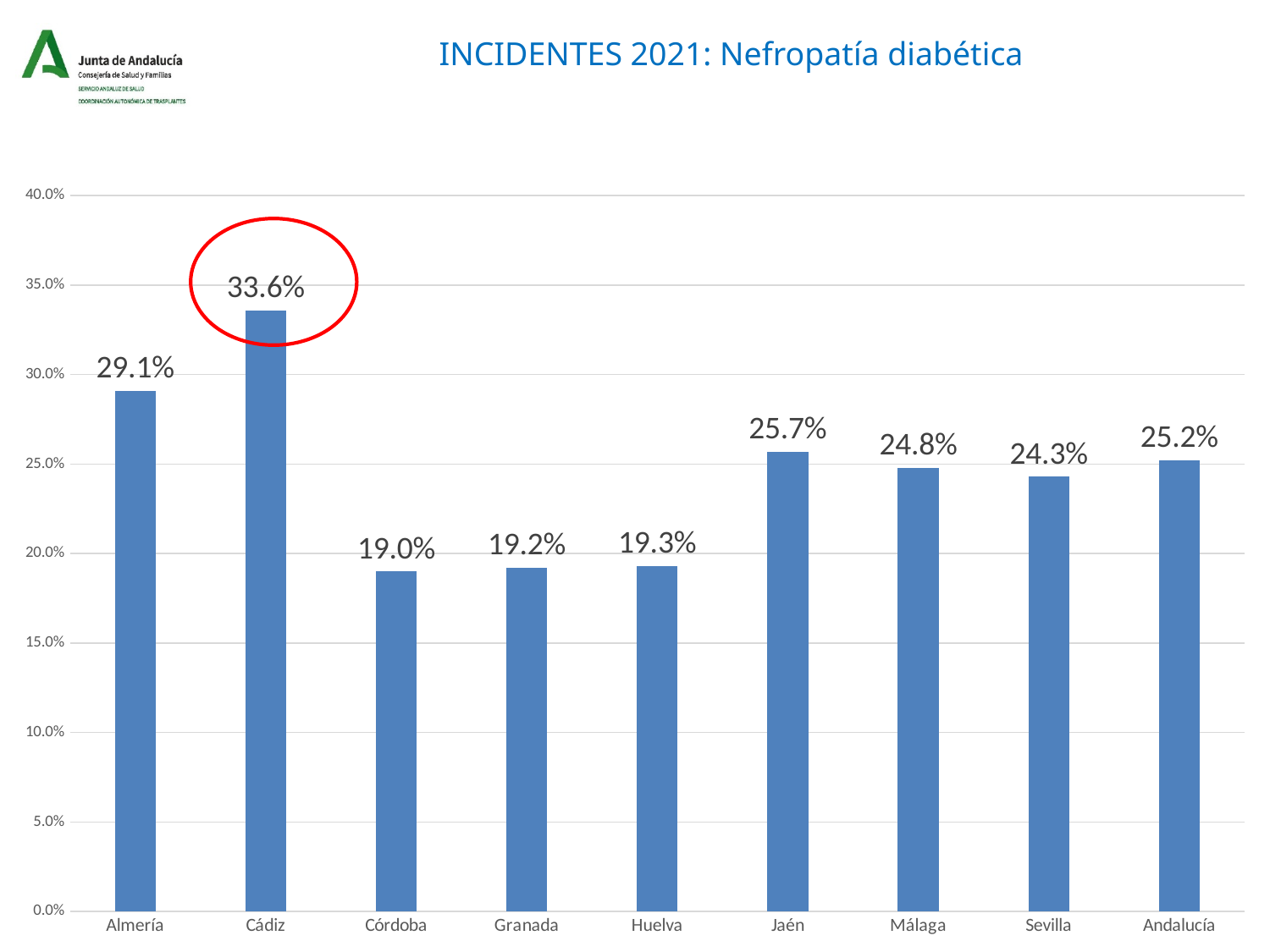
Which category has the highest value? Cádiz What is the difference between the values for Jaén and Sevilla? 1.4% What is the value for Andalucía? 25.2% What is the title of the slide? INCIDENTES 2021: Nefropatía diabética How many categories are shown on the x axis? 9 Which category has the lowest value? Córdoba Is the value for Huelva greater or less than 20.0%? less What is the value for Cádiz? 33.6% What kind of chart is shown on the slide? bar chart Which is larger, the value for Málaga or the value for Sevilla? Málaga What is the value for Jaén? 25.7% What is the difference between the values for Cádiz and Almería? 4.5%